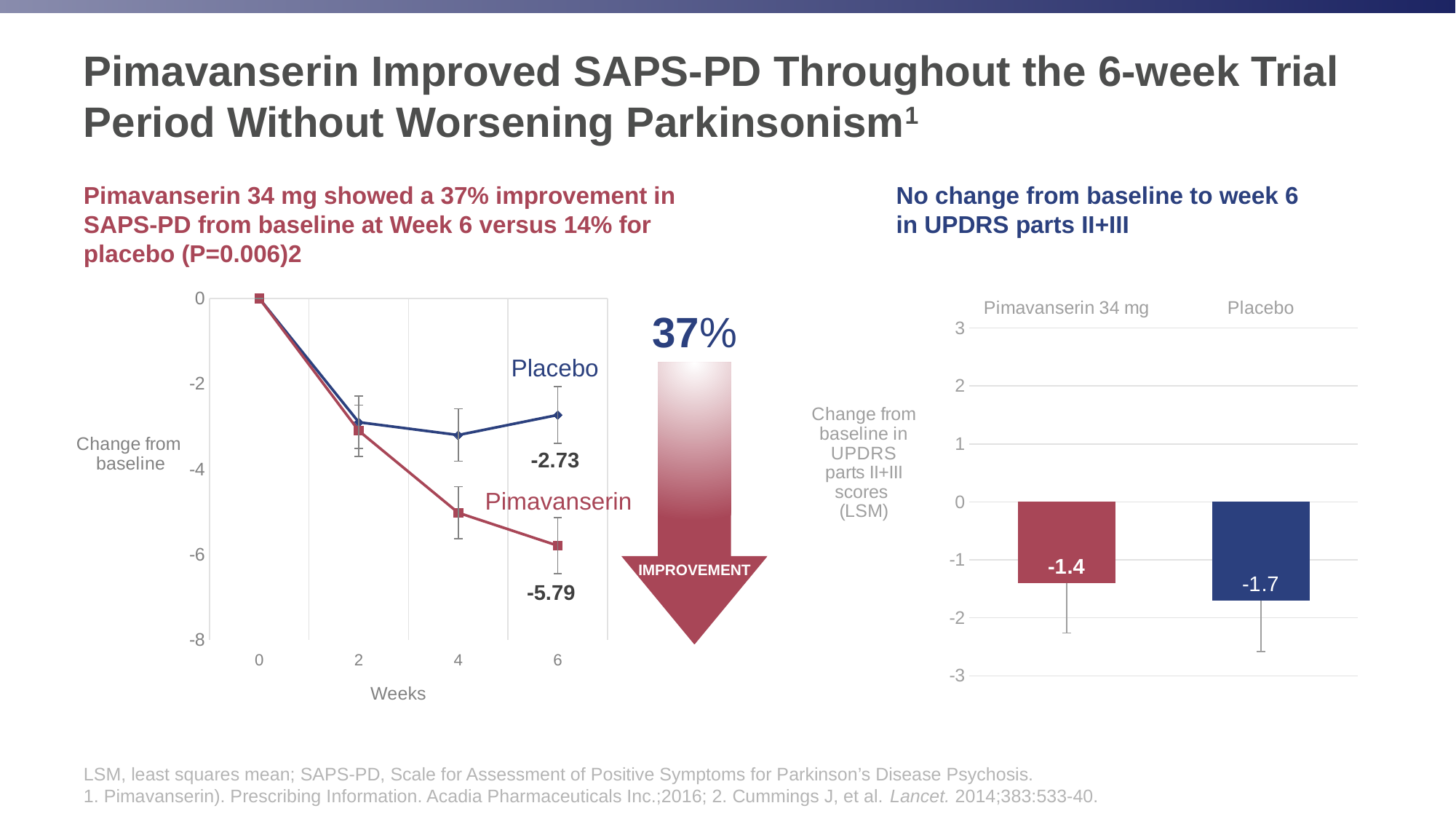
In the right bar chart, how many bars are plotted? 2 In the left line chart, what is the difference between the Placebo and Pimavanserin values at week 6? 3.06 In the right bar chart, what is the change from baseline in UPDRS parts II+III scores for Pimavanserin 34 mg? -1.4 In the left line chart, is the Pimavanserin value at week 4 greater or less than -4? less In the left line chart, how many time points are plotted along the Weeks axis? 4 What kind of chart is the chart on the right side of the slide? bar chart In the left line chart, what is the change from baseline for Placebo at week 6? -2.73 In the right bar chart, what is the change from baseline in UPDRS parts II+III scores for Placebo? -1.7 In the left line chart, which series has the lower value at week 6, Placebo or Pimavanserin? Pimavanserin In the left line chart, do the Pimavanserin values rise or fall from week 0 to week 6? fall In the right bar chart, what is the difference between the Pimavanserin 34 mg and Placebo values? 0.3 In the left line chart, what is the change from baseline for Pimavanserin at week 6? -5.79